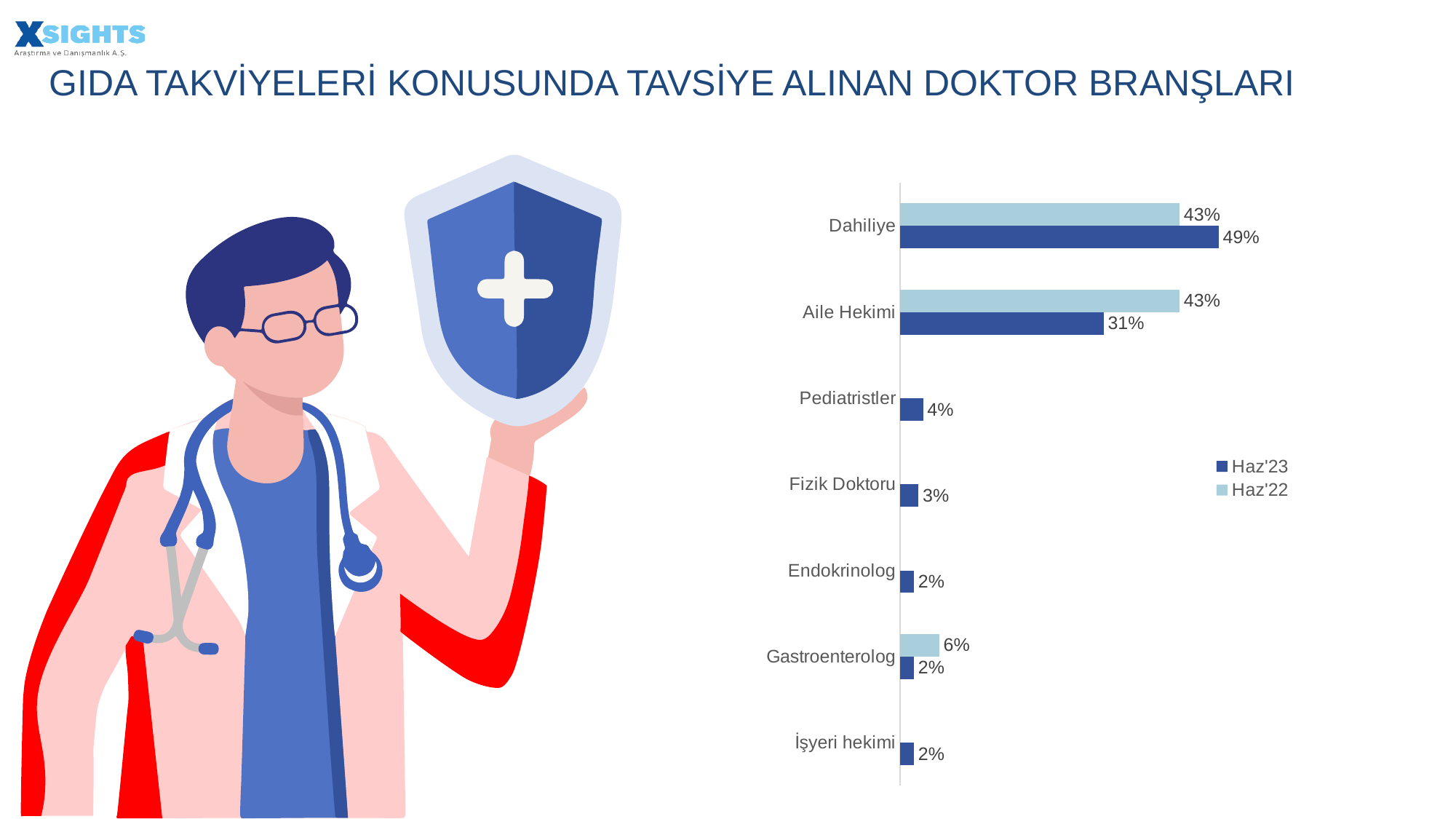
What is the Haz'23 value for Pediatristler? 4% How many categories are shown on the chart? 7 What is the Haz'22 value for Gastroenterolog? 6% Which category has the highest Haz'23 value? Dahiliye What is the difference between the Haz'23 and Haz'22 values for Aile Hekimi? 12% What is the Haz'23 value for Dahiliye? 49% What is the Haz'22 value for Aile Hekimi? 43% What is the difference between the Haz'23 values for Dahiliye and Aile Hekimi? 18% Which series is shown in the lighter blue colour? Haz'22 Which is larger for Gastroenterolog, the Haz'22 value or the Haz'23 value? Haz'22 How many series does the legend list? 2 What kind of chart is shown on the slide? Bar chart